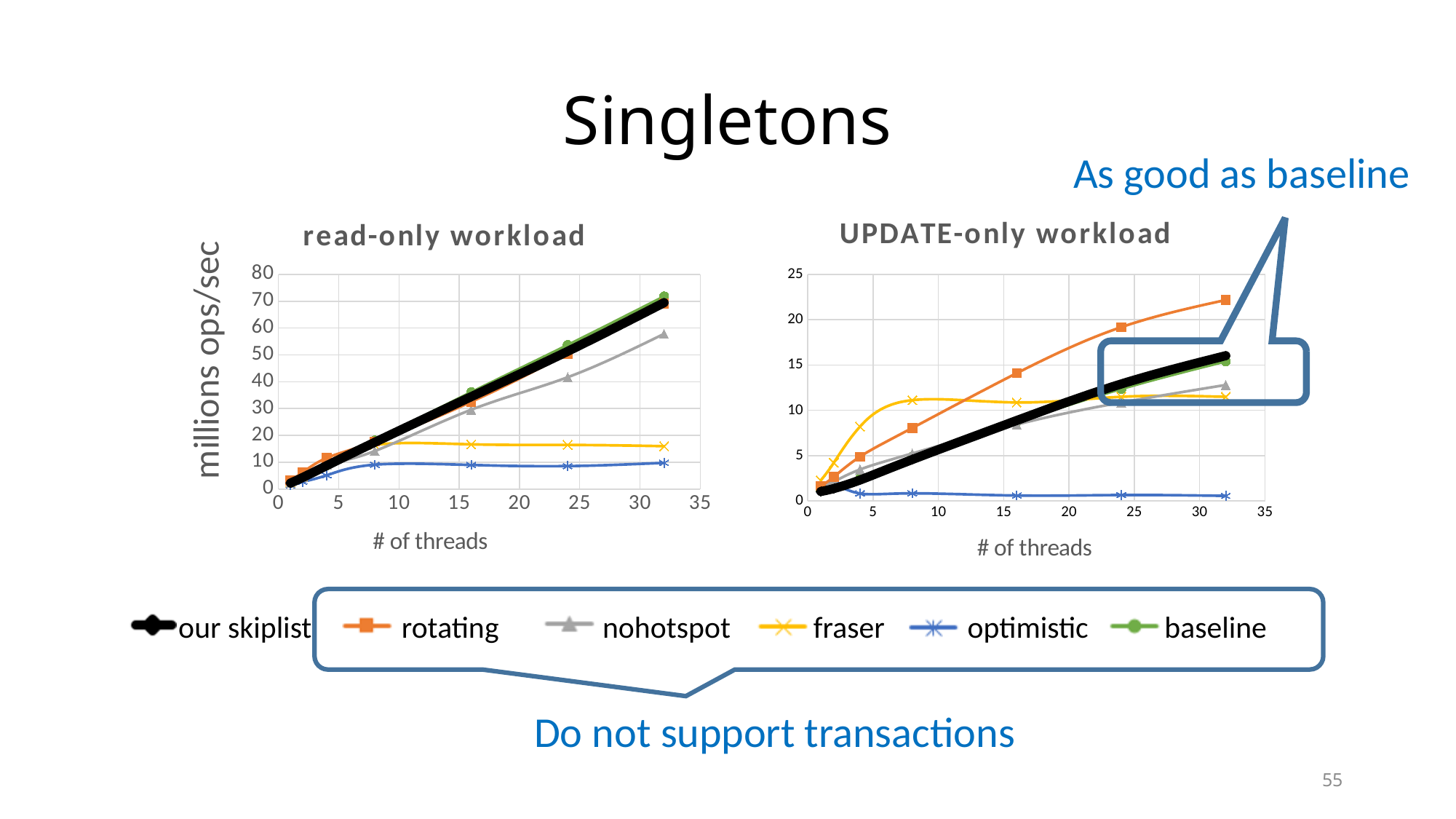
What is the label on the y axis of the "read-only workload" chart? millions ops/sec In the "UPDATE-only workload" chart, is the value for rotating at 32 threads greater or less than 20? greater What kind of chart is the "read-only workload" chart? line chart In the "read-only workload" chart, does the value for our skiplist rise or fall as the number of threads increases? rise In the "UPDATE-only workload" chart, which is larger at 8 threads, fraser or rotating? fraser In the "read-only workload" chart, is the value for nohotspot at 32 threads greater or less than 50? greater How many series does the legend list? 6 In the "read-only workload" chart, is the value for optimistic at 32 threads greater or less than 20? less In the "UPDATE-only workload" chart, which series has the lowest value at 32 threads? optimistic In the "read-only workload" chart, which is larger at 32 threads, nohotspot or fraser? nohotspot In the "UPDATE-only workload" chart, which series has the highest value at 32 threads? rotating What is the title of the chart on the right? UPDATE-only workload